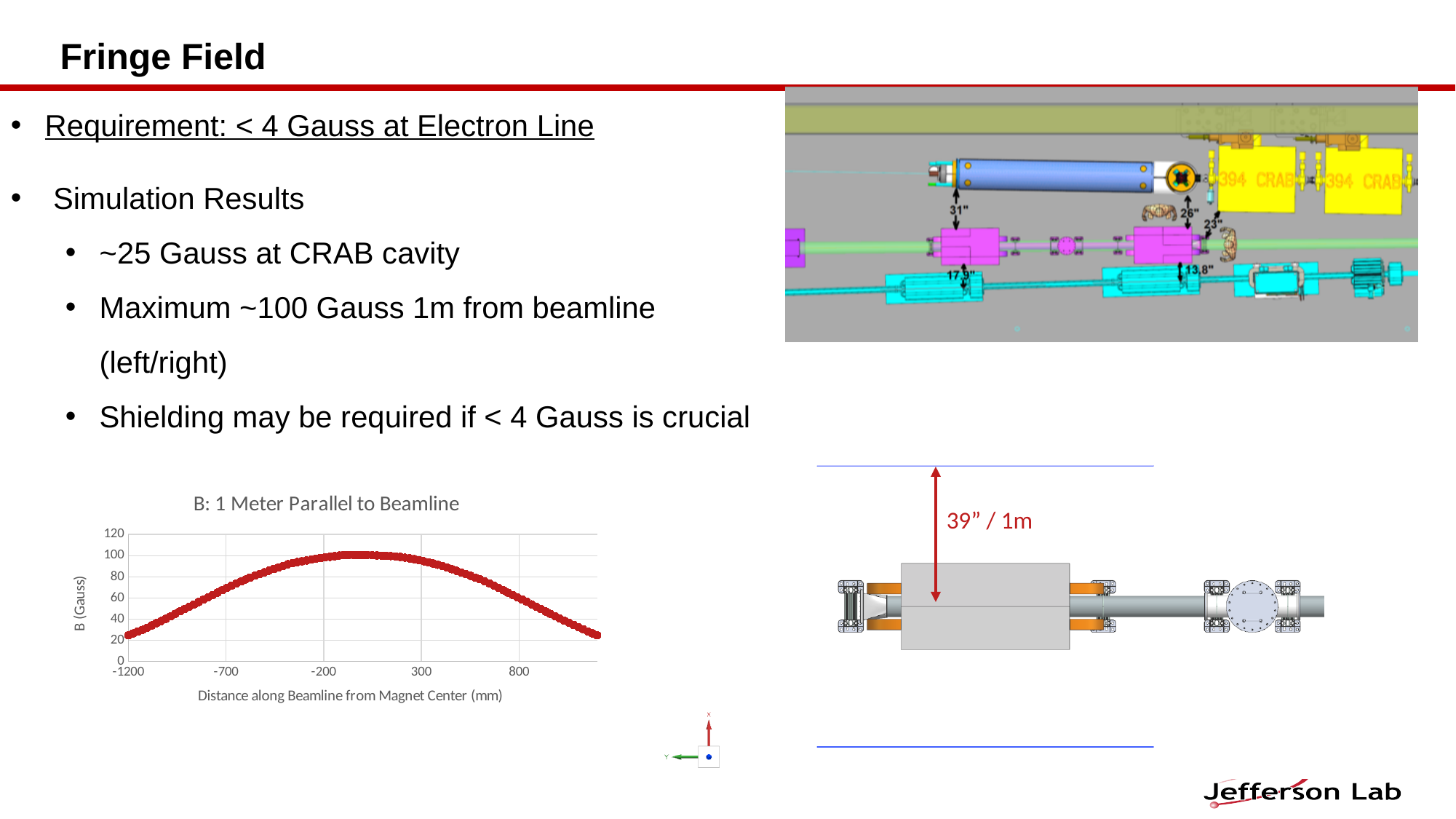
What type of chart is shown under the title "B: 1 Meter Parallel to Beamline"? scatter chart What is the label of the x axis of the chart? Distance along Beamline from Magnet Center (mm) What is the title of the chart on the slide? B: 1 Meter Parallel to Beamline In the chart, is the highest value of B found near the magnet center or at the ends of the distance range? near the magnet center In the chart, is B larger at a distance of -1200 mm or at a distance of -700 mm? -700 mm In the chart, is the value of B at a distance of -700 mm greater or less than 40 Gauss? greater In the chart, is the value of B at a distance of 0 mm greater or less than 80 Gauss? greater In the chart, does B rise or fall as the distance increases from -1200 mm to 0 mm? rise In the chart, does B rise or fall as the distance increases from 0 mm to the right end of the axis? fall In the chart, is B larger at a distance of -1200 mm or at a distance of 0 mm? 0 mm In the chart, is the value of B at a distance of -1200 mm greater or less than 40 Gauss? less